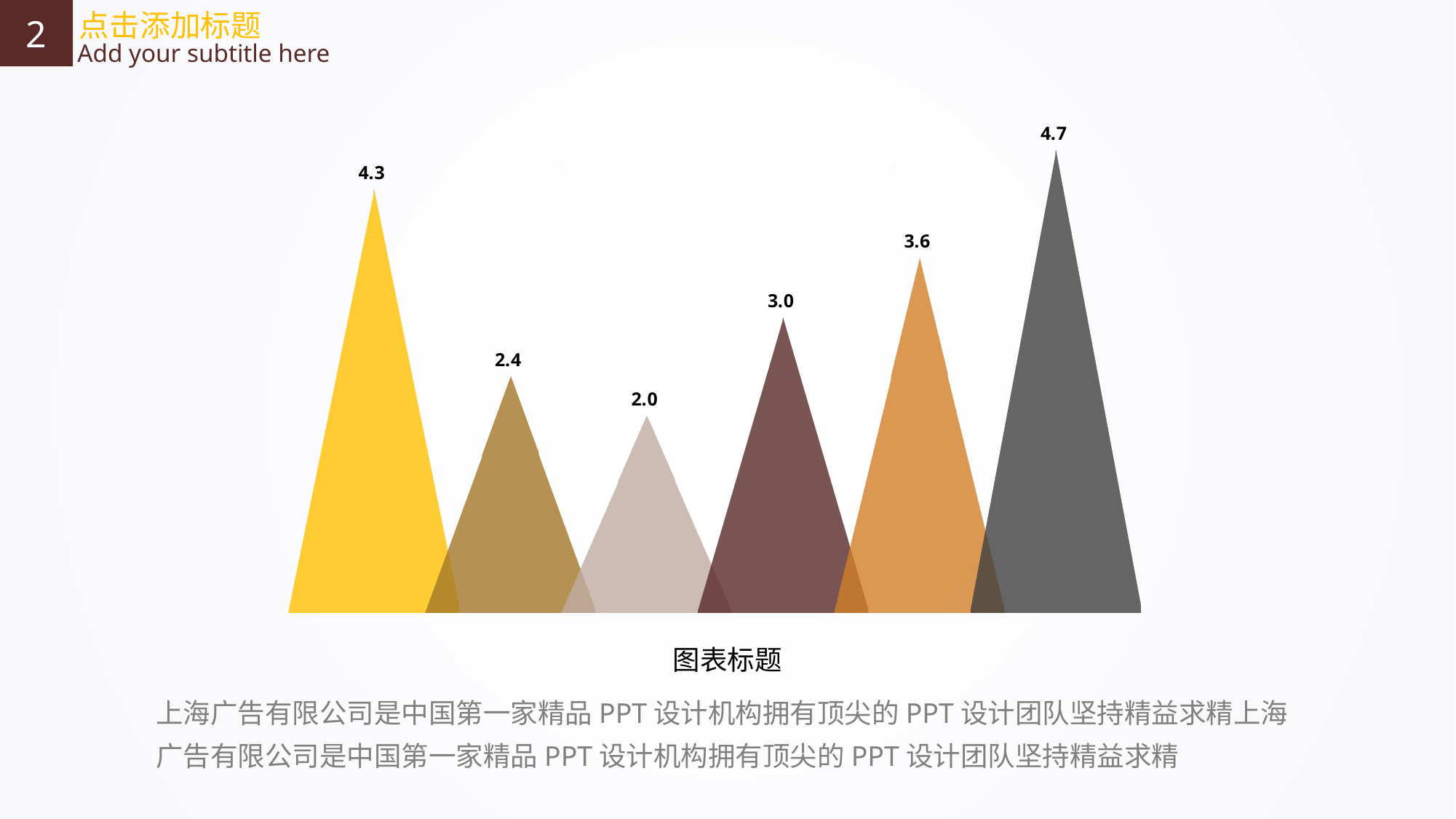
What is the value of the orange bar, fifth from the left? 3.6 Which bar has the highest value in the chart? The rightmost (dark grey) bar, 4.7 What is the value of the first (leftmost, yellow) bar in the chart? 4.3 What is the difference between the first bar (4.3) and the second bar (2.4)? 1.9 Which bar has the lowest value in the chart? The third bar from the left (light beige), 2.0 What is the title shown below the chart? 图表标题 What type of chart is shown on the slide? Bar chart (with triangle-shaped bars) What is the value of the dark brown bar, fourth from the left? 3.0 What is the difference between the highest value (4.7) and the lowest value (2.0) in the chart? 2.7 How many bars are plotted in the chart? 6 What is the value of the third bar from the left (the light beige one)? 2.0 Which is larger, the value of the yellow bar on the far left or the dark grey bar on the far right? The dark grey bar on the far right (4.7)